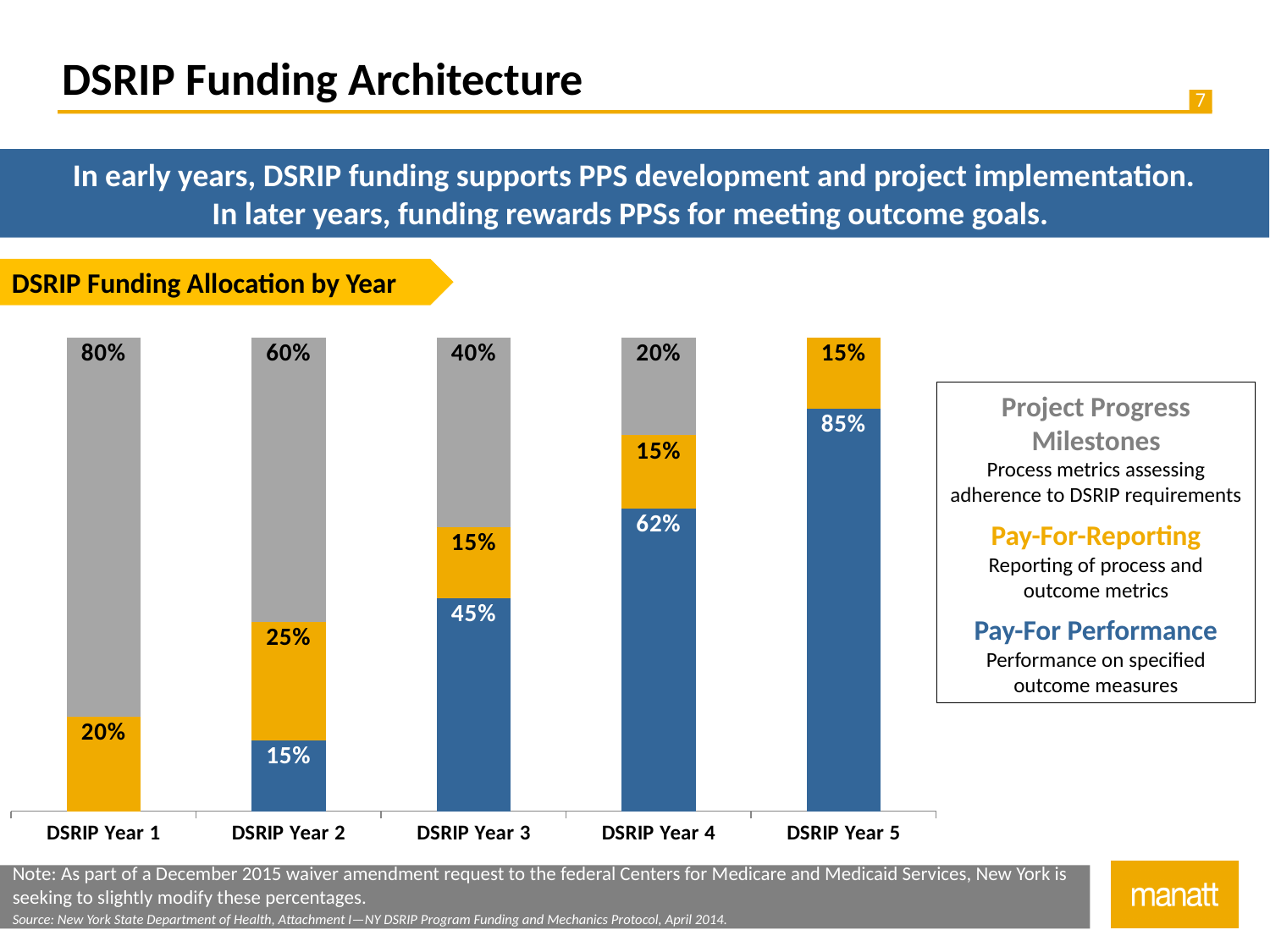
Which year has the lowest Project Progress Milestones share among the years where it is shown? DSRIP Year 4 Which year has the highest Pay-For Performance share? DSRIP Year 5 What kind of chart is shown? Stacked bar chart What is the Pay-For-Reporting share in DSRIP Year 5? 15% What is the difference between the Pay-For Performance share in DSRIP Year 5 and in DSRIP Year 4? 23% What is the total of the DSRIP Year 3 bar? 100% What is the Project Progress Milestones share in DSRIP Year 2? 60% How many funding categories does the legend box list? 3 Which is larger in DSRIP Year 2: the Pay-For-Reporting share or the Pay-For Performance share? Pay-For-Reporting Does the Pay-For Performance share rise or fall from DSRIP Year 2 to DSRIP Year 5? Rise What is the Pay-For Performance share in DSRIP Year 3? 45% How many years are shown on the x axis? 5